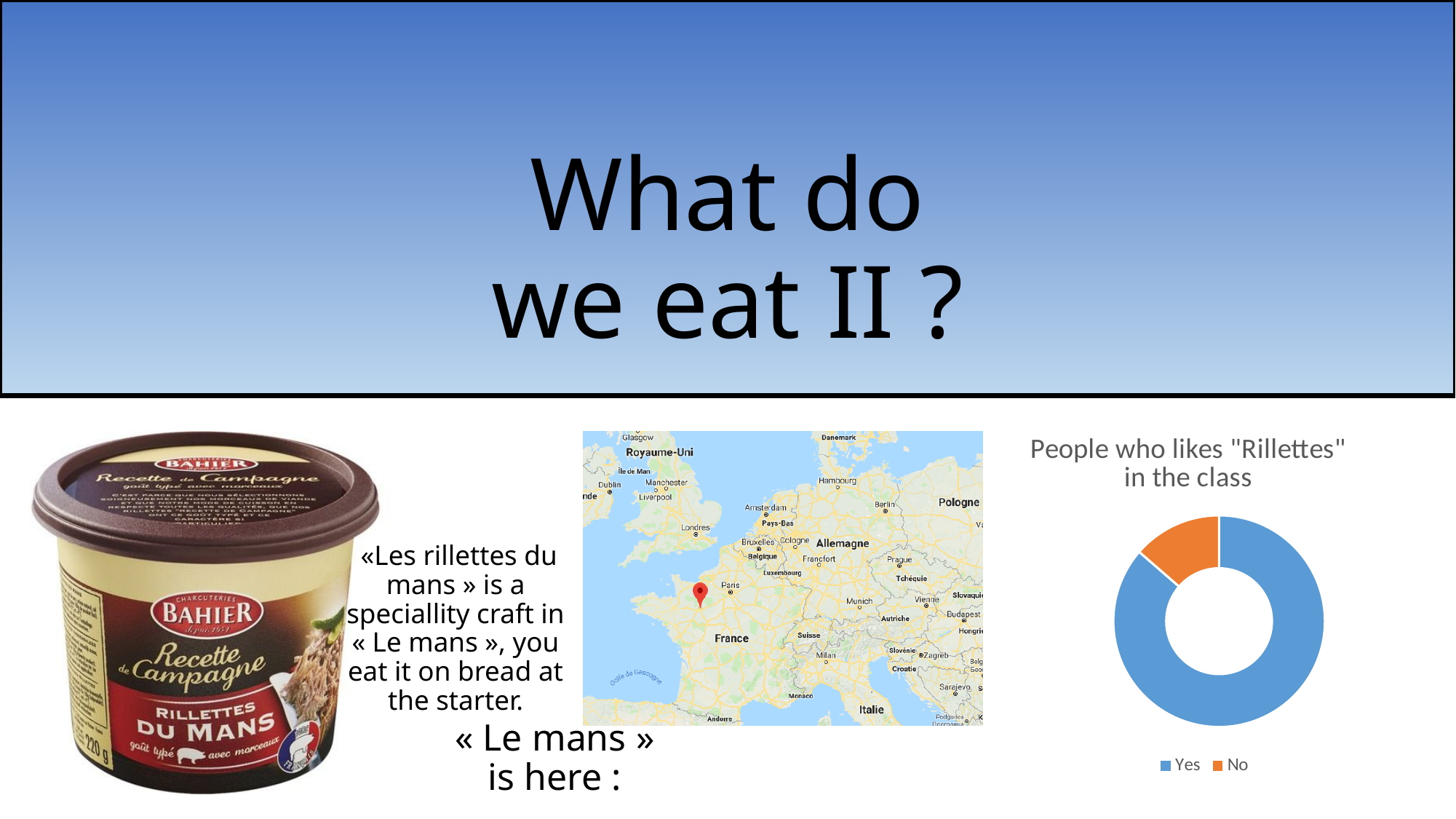
How many categories does the doughnut chart show? 2 Which category has the largest share of the doughnut chart? Yes What kind of chart is shown on the slide? doughnut chart Which category has the smallest share of the doughnut chart? No Does the "Yes" slice take up more or less than half of the doughnut chart? more What is the title of the chart? People who likes "Rillettes" in the class What colour represents the "No" category in the chart? orange Which is larger in the chart, the share for Yes or the share for No? Yes How many entries does the chart legend list? 2